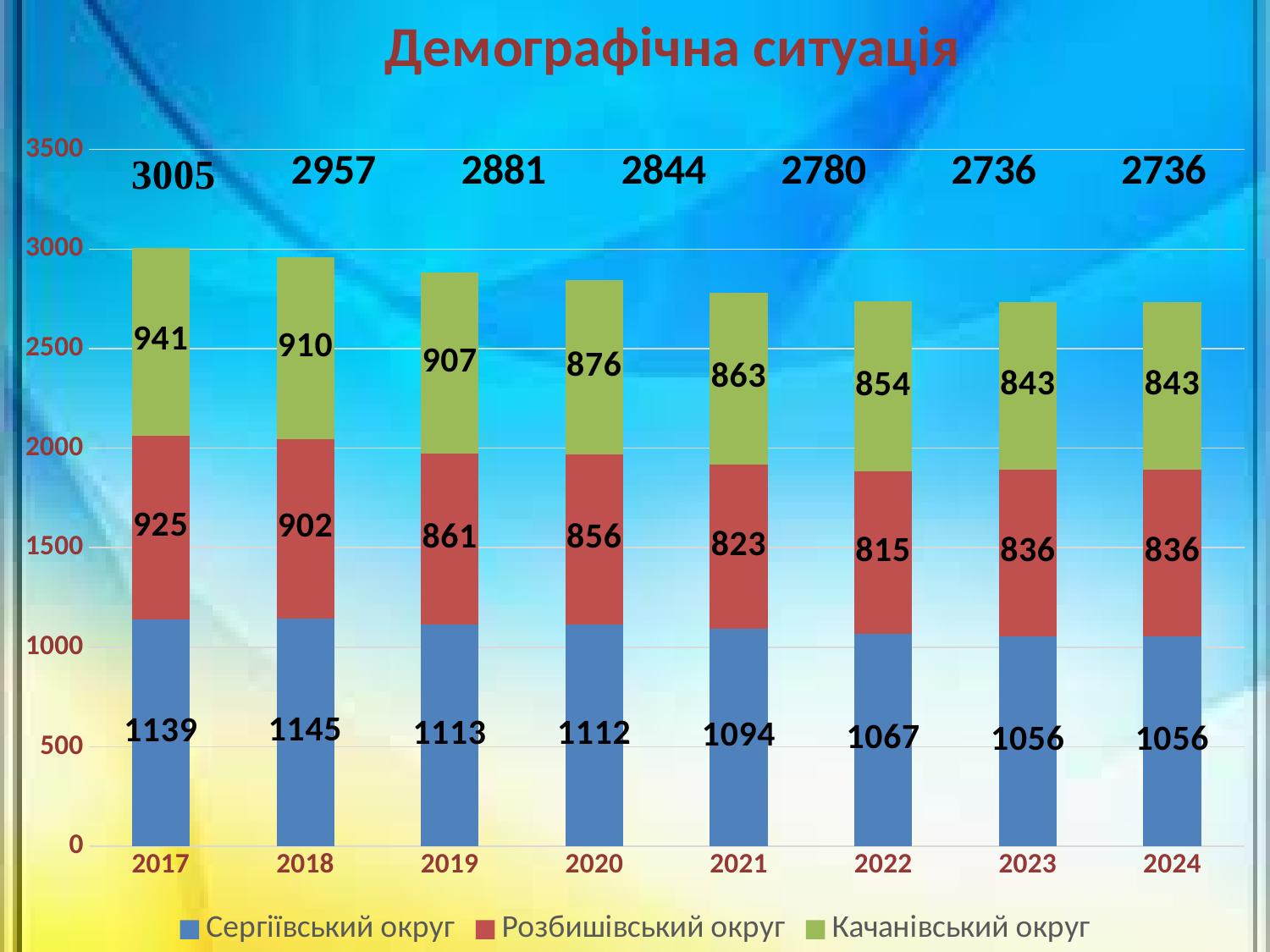
What is the value for Сергіївський округ in 2017? 1139 In which year is the value for Розбишівський округ lowest? 2022 In which year is the value for Сергіївський округ highest? 2018 Which is larger in 2019: the value for Розбишівський округ or the value for Качанівський округ? Качанівський округ How many years are shown on the x axis? 8 What kind of chart is shown on the slide? stacked bar chart What is the total of the stacked bar for 2017? 3005 What is the difference between the Качанівський округ values for 2017 and 2024? 98 What is the value for Качанівський округ in 2020? 876 How many series does the legend list? 3 What is the value for Розбишівський округ in 2021? 823 Does the value for Сергіївський округ generally rise or fall from 2017 to 2024? fall